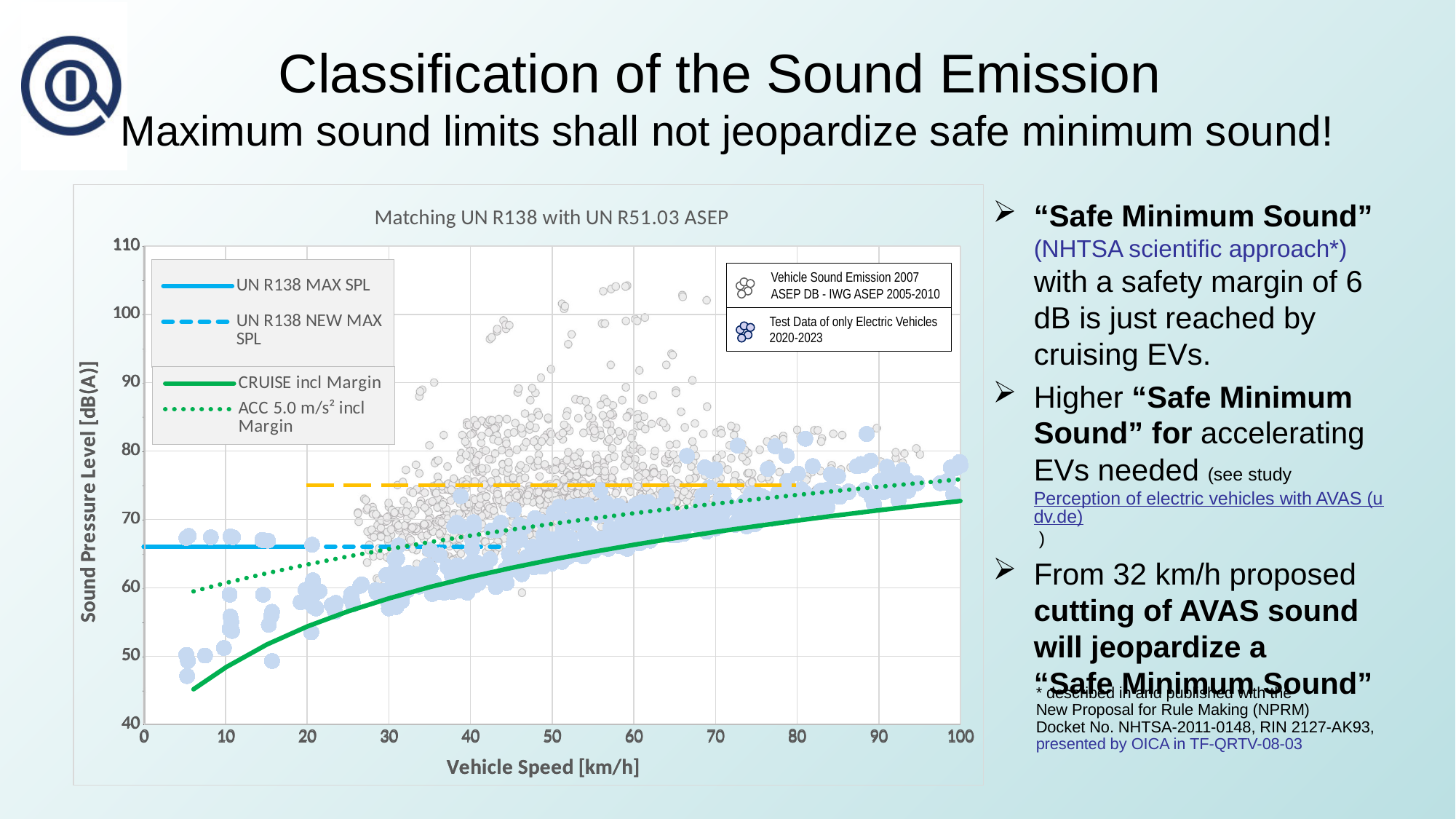
At 100 km/h, which line is higher: ACC 5.0 m/s² incl Margin or CRUISE incl Margin? ACC 5.0 m/s² incl Margin What is the title of the chart? Matching UN R138 with UN R51.03 ASEP Is the UN R138 MAX SPL line greater or less than 60 dB(A)? greater How many entries does the legend box in the upper left of the chart list? 4 What kind of chart is shown on the slide? scatter chart Is the value of the CRUISE incl Margin line at 10 km/h greater or less than 60 dB(A)? less Does the CRUISE incl Margin line rise or fall as vehicle speed increases? rises What is the label of the chart's x axis? Vehicle Speed [km/h] Is the UN R138 MAX SPL line greater or less than 70 dB(A)? less At 10 km/h, which is higher: the UN R138 MAX SPL line or the CRUISE incl Margin line? UN R138 MAX SPL